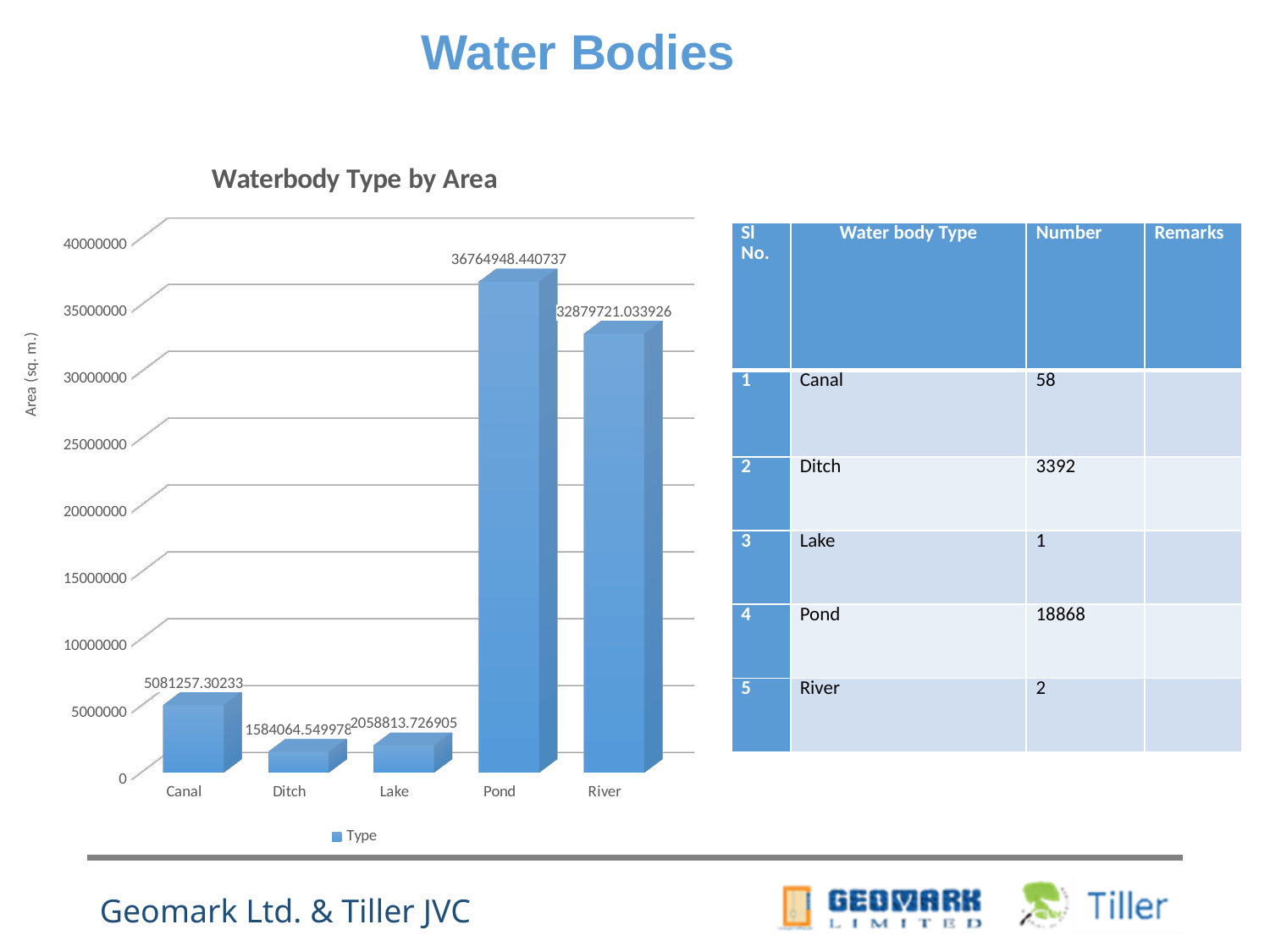
What is the value for Ditch in the Waterbody Type by Area chart? 1584064.549978 Which is larger in the chart, the value for Canal or the value for Lake? Canal How many waterbody types are shown on the x axis of the chart? 5 What is the value for Pond in the Waterbody Type by Area chart? 36764948.440737 What is the value for Canal in the Waterbody Type by Area chart? 5081257.30233 What is the difference between the Lake and Ditch values in the chart? 474749.176927 Is the value for River in the chart greater or less than 30000000? greater What is the value for River in the Waterbody Type by Area chart? 32879721.033926 Which waterbody type has the largest area in the chart? Pond What kind of chart is Waterbody Type by Area? bar chart Which waterbody type has the smallest area in the chart? Ditch What is the difference between the Pond and River values in the chart? 3885227.406811